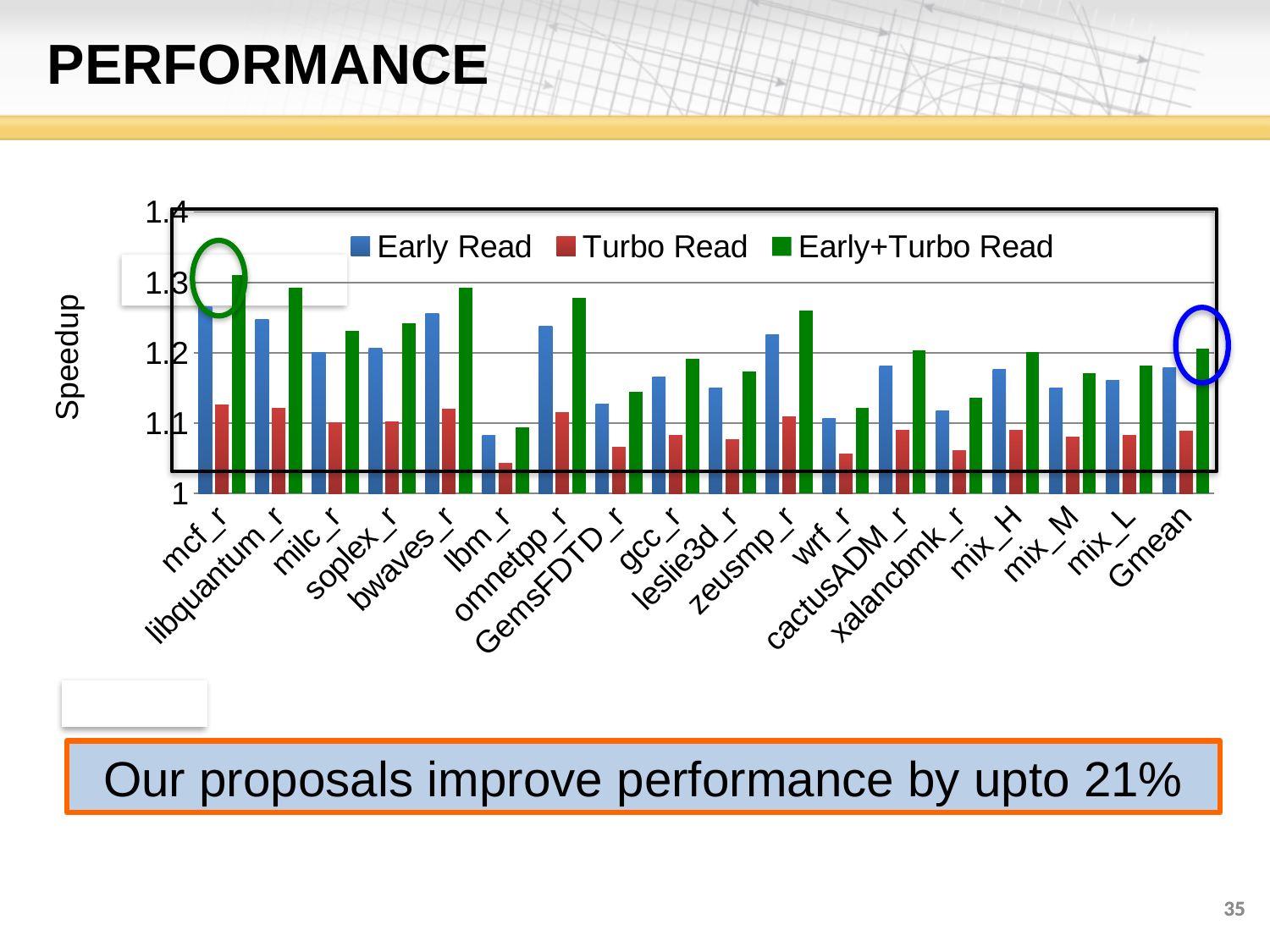
Is the Turbo Read value for wrf_r greater or less than 1.1? less Is the Early+Turbo Read value for mcf_r greater or less than 1.3? greater Which category has the lowest Turbo Read speedup? lbm_r How many categories are shown along the x axis? 18 What kind of chart is shown on the slide? Bar chart Which category has the highest Early+Turbo Read speedup? mcf_r How many series does the legend list? 3 What is the label on the y axis? Speedup Which category has the lowest Early+Turbo Read speedup? lbm_r Is the Early Read value for Gmean greater or less than 1.2? less For zeusmp_r, which is larger: the Early Read value or the Turbo Read value? Early Read